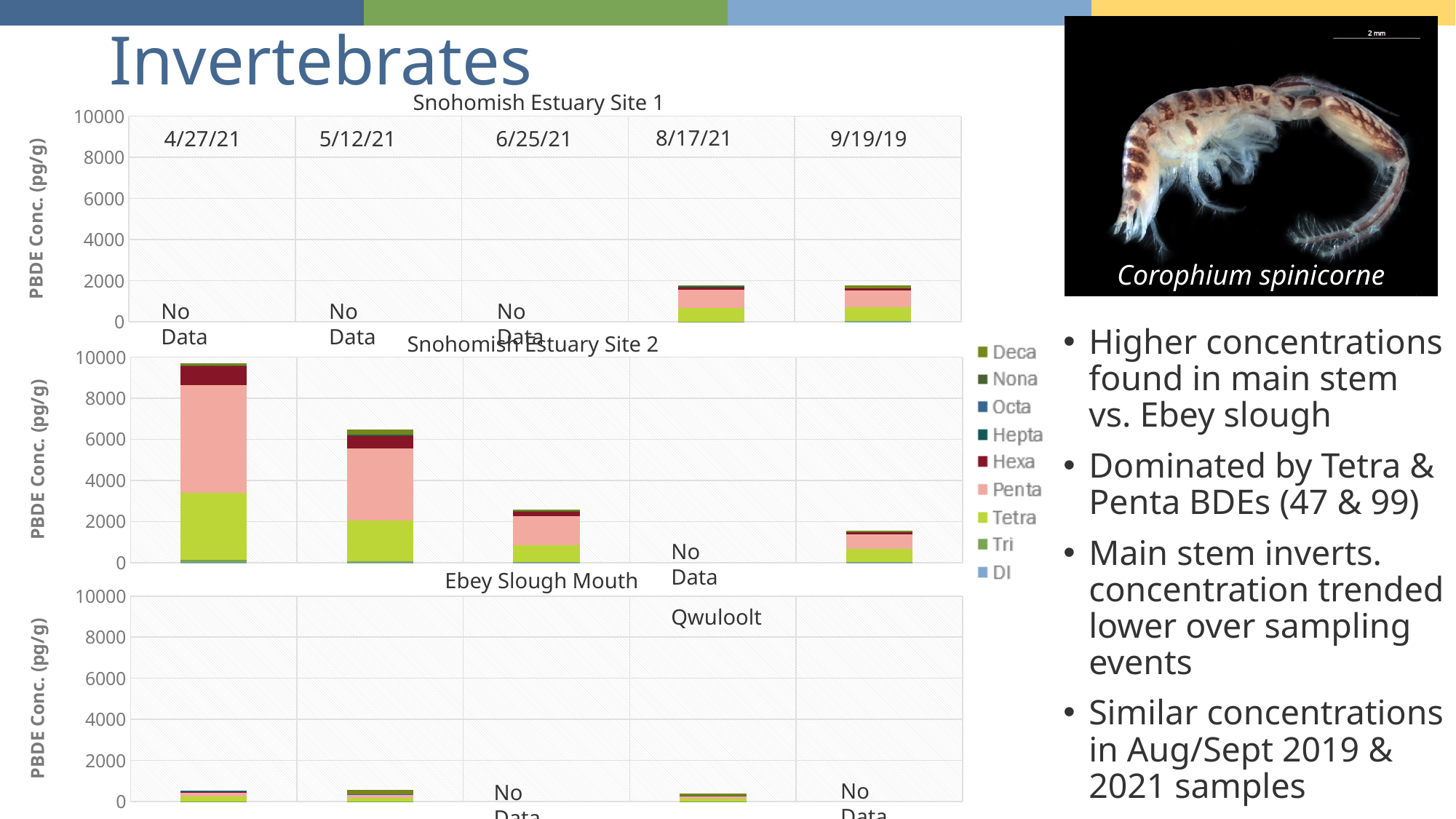
In the Snohomish Estuary Site 2 chart, is the total value for 6/25/21 greater or less than 4000? less What kind of chart is used for the Snohomish Estuary Site 2 data? Stacked bar chart In the Snohomish Estuary Site 2 chart, which has the larger total, 4/27/21 or 6/25/21? 4/27/21 In the Snohomish Estuary Site 2 chart, do the total concentrations rise or fall across the sampling dates from 4/27/21 to 9/19/19? Fall In the Snohomish Estuary Site 2 chart, which sampling date has the highest total PBDE concentration? 4/27/21 How many series does the legend list for the charts? 9 In the Snohomish Estuary Site 2 chart, is the total value for 5/12/21 greater or less than 4000? greater In the Snohomish Estuary Site 2 chart, is the total value for 4/27/21 greater or less than 8000? greater In the Snohomish Estuary Site 1 chart, how many sampling dates are marked 'No Data'? 3 What is the y-axis label on the charts? PBDE Conc. (pg/g)